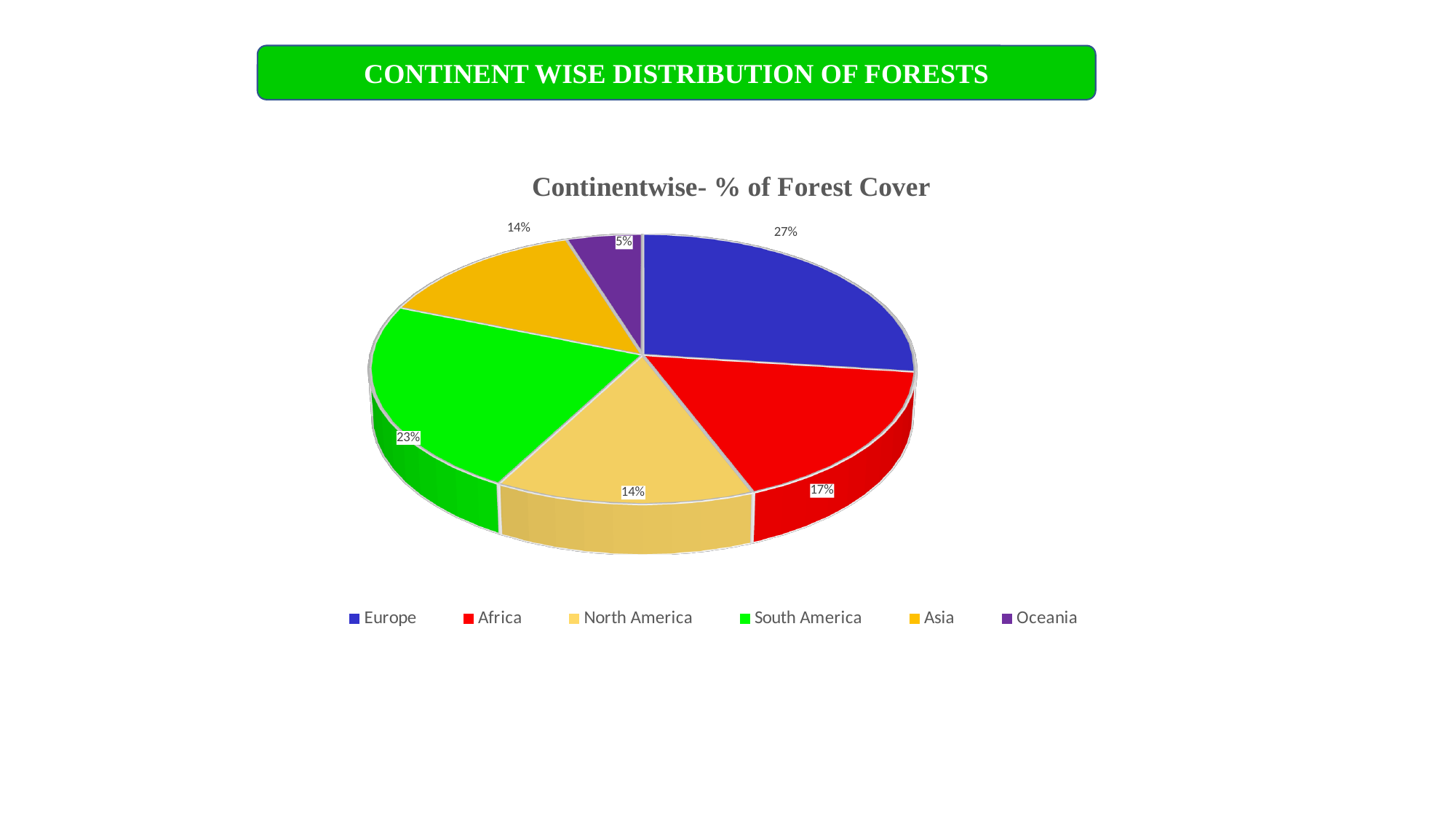
What type of chart is shown on the slide? Pie chart How many continents are shown in the pie chart? 6 What percentage of forest cover does Oceania have? 5% What percentage of forest cover does Africa have? 17% What colour represents Asia in the chart? Orange What percentage of forest cover does Europe have? 27% Which continent has the smallest share of forest cover? Oceania What is the title of the chart? Continentwise- % of Forest Cover What is the difference between Europe's and Africa's shares of forest cover? 10% Which has a larger share of forest cover, South America or Africa? South America What percentage of forest cover does South America have? 23% Which continent has the largest share of forest cover? Europe